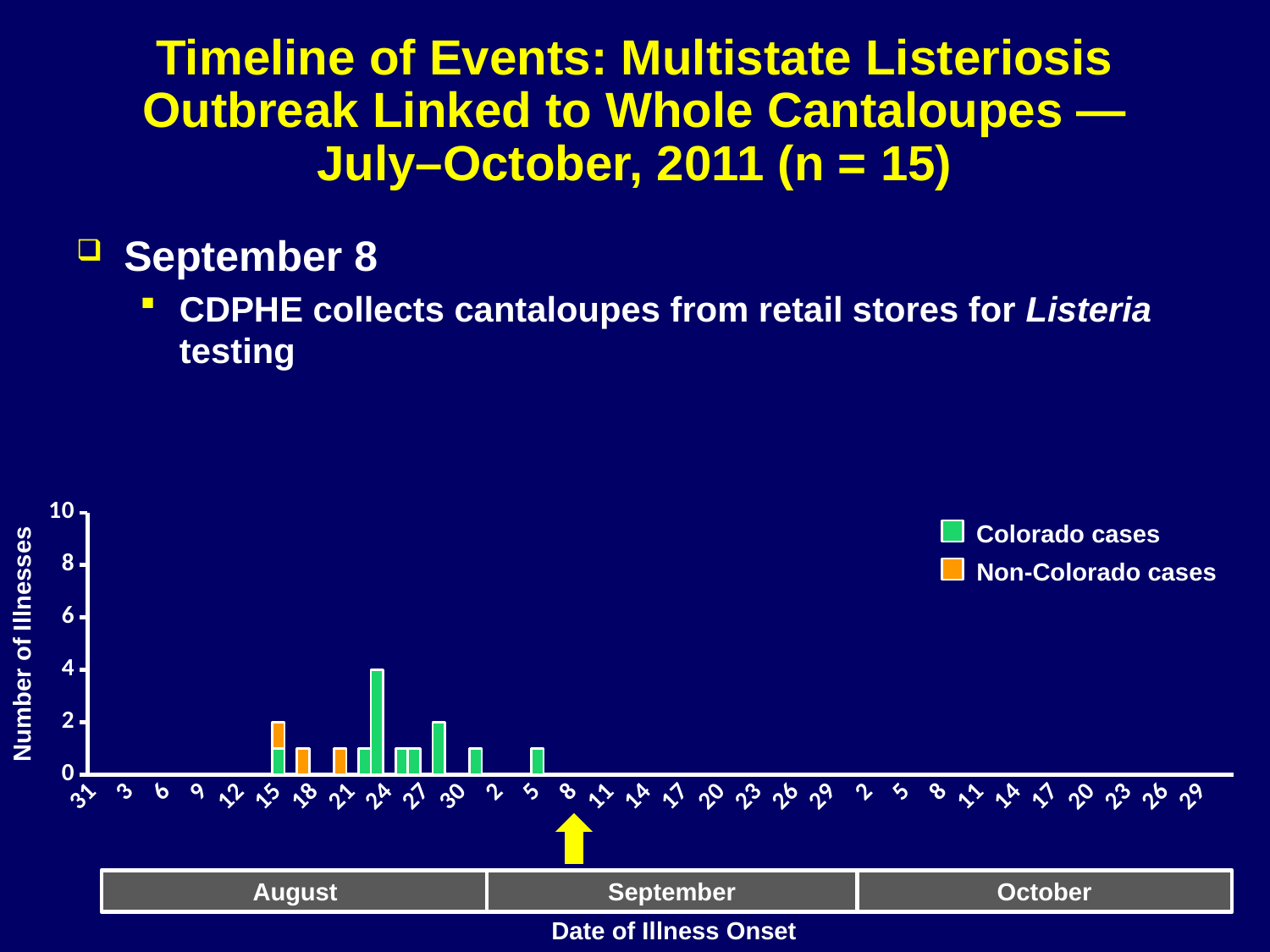
What kind of chart is shown on the slide? bar chart How many series does the chart legend list? 2 Which series does the tallest bar in the chart belong to? Colorado cases What is the number of illnesses for the tallest bar in the chart? 4 How many months are labeled along the x axis of the chart? 3 Is the number of illnesses for the bar at September 5 greater or less than 2? less What is the title of the chart's vertical axis? Number of Illnesses Is the value of the tallest bar greater or less than 6? less Do the illness counts rise or fall moving from late August into October? fall Which is taller, the bar at August 15 or the bar at September 5? August 15 What are the two series named in the chart legend? Colorado cases and Non-Colorado cases What is the total height of the stacked bar at August 15? 2